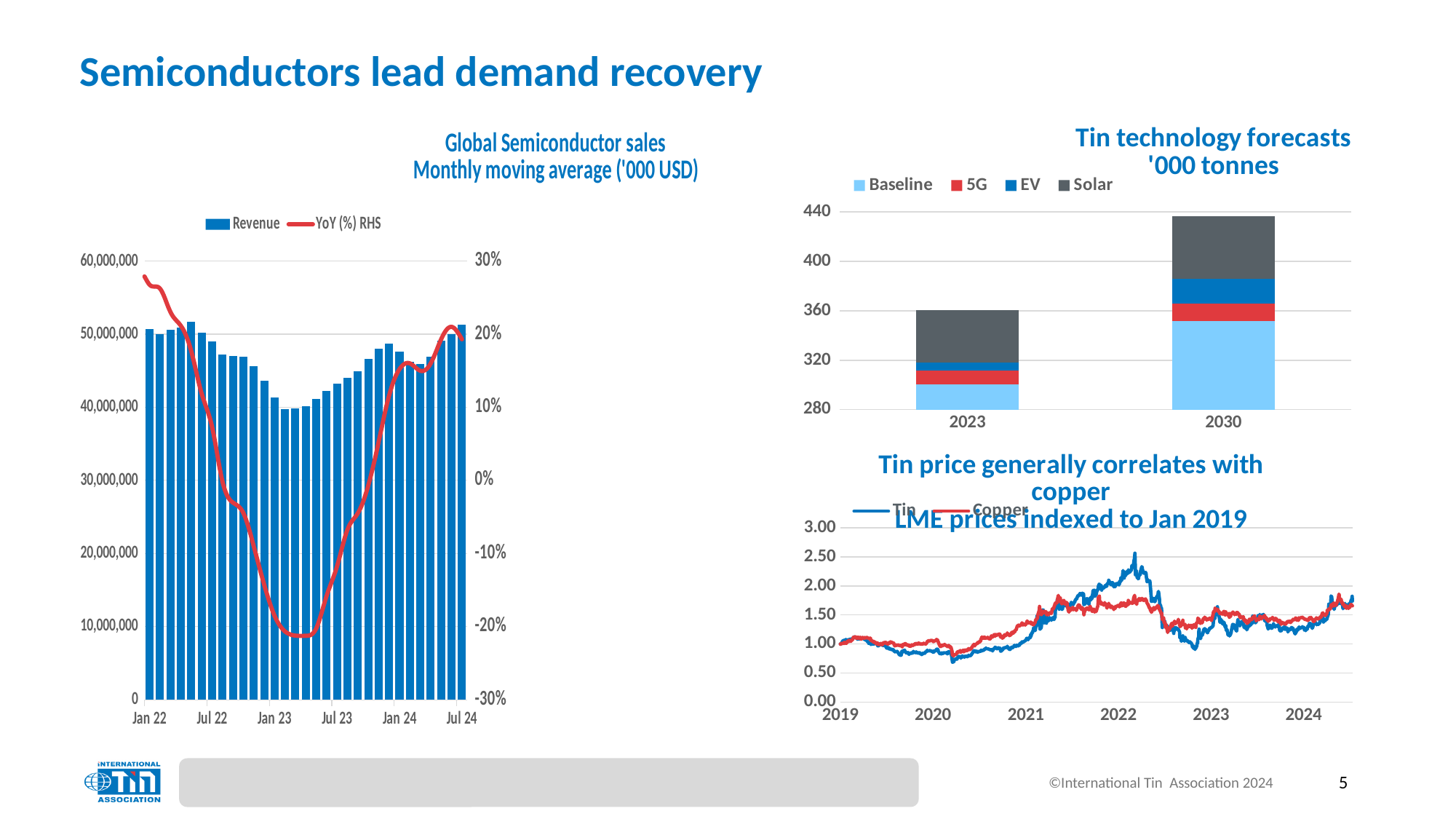
On the Global Semiconductor sales chart, is the Revenue value at Jan 23 greater or less than 50,000,000? less On the Tin price generally correlates with copper chart, which series reaches the higher peak during 2022, Tin or Copper? Tin On the Tin technology forecasts chart, how many years are shown on the x axis? 2 On the Global Semiconductor sales chart, does Revenue rise or fall from Jul 23 to Jul 24? rise On the Tin technology forecasts chart, is the total stacked value for 2030 greater or less than 400? greater On the Tin technology forecasts chart, which year has the larger total stacked bar, 2023 or 2030? 2030 On the Global Semiconductor sales chart, is the YoY (%) value around Jan 23 greater or less than 0%? less On the Tin technology forecasts chart, how many series does the legend list? 4 On the Tin technology forecasts chart, what kind of chart is it? Stacked bar chart On the Global Semiconductor sales chart, how many series does the legend list? 2